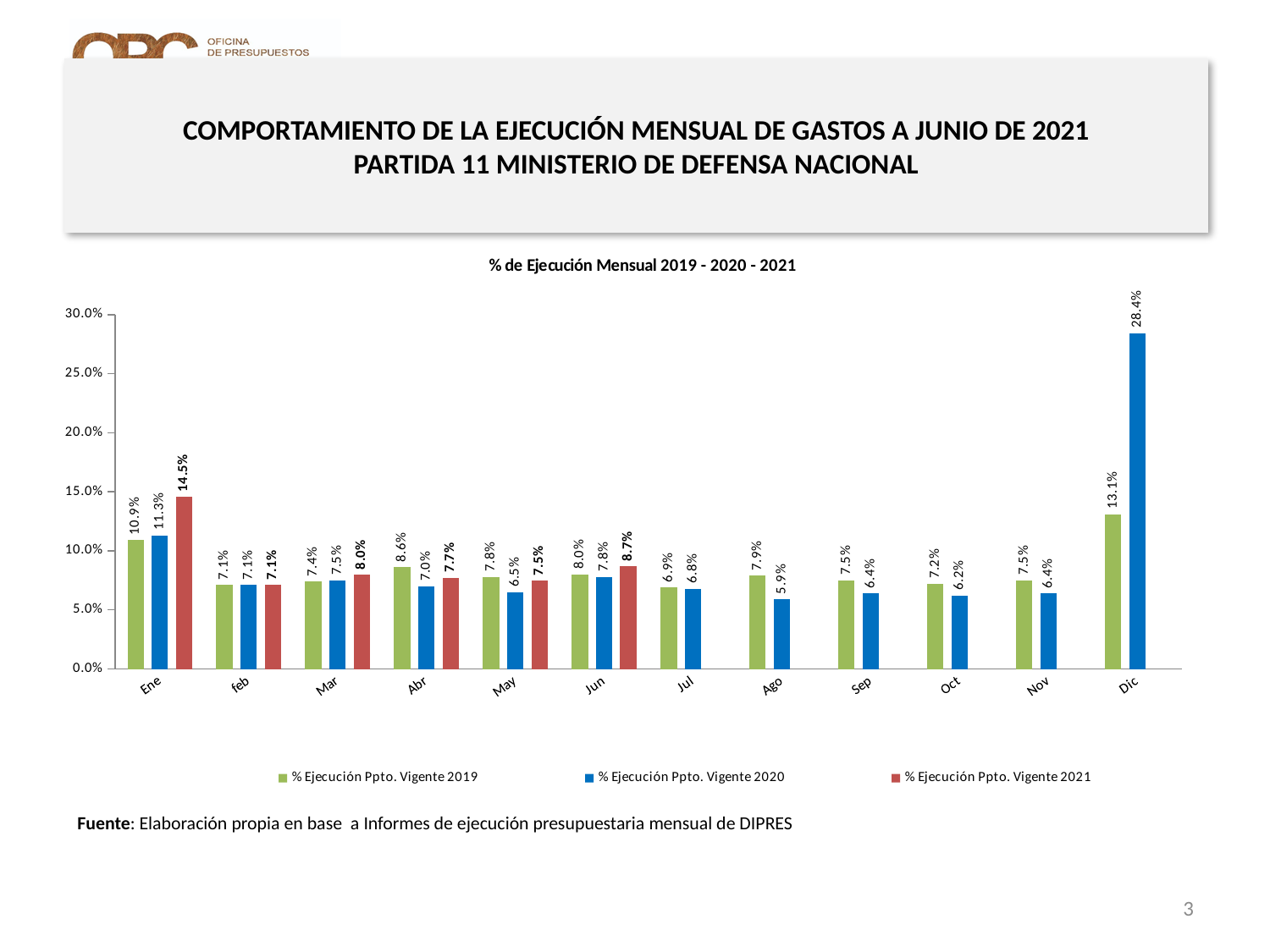
What is the difference between the 2020 and 2019 values in Dic? 15.3% Is the value for % Ejecución Ppto. Vigente 2021 in Ene greater or less than 10.0%? greater What is the value for % Ejecución Ppto. Vigente 2020 in Dic? 28.4% What is the value for % Ejecución Ppto. Vigente 2019 in Abr? 8.6% Which month has the highest value for % Ejecución Ppto. Vigente 2020? Dic How many months are shown on the x axis? 12 What is the value for % Ejecución Ppto. Vigente 2021 in Ene? 14.5% Which month has the lowest value for % Ejecución Ppto. Vigente 2020? Ago Which is larger in May: the 2019 value or the 2020 value? 2019 value (7.8%) How many series does the legend list? 3 What is the title of the chart? % de Ejecución Mensual 2019 - 2020 - 2021 What kind of chart is shown on the slide? Bar chart